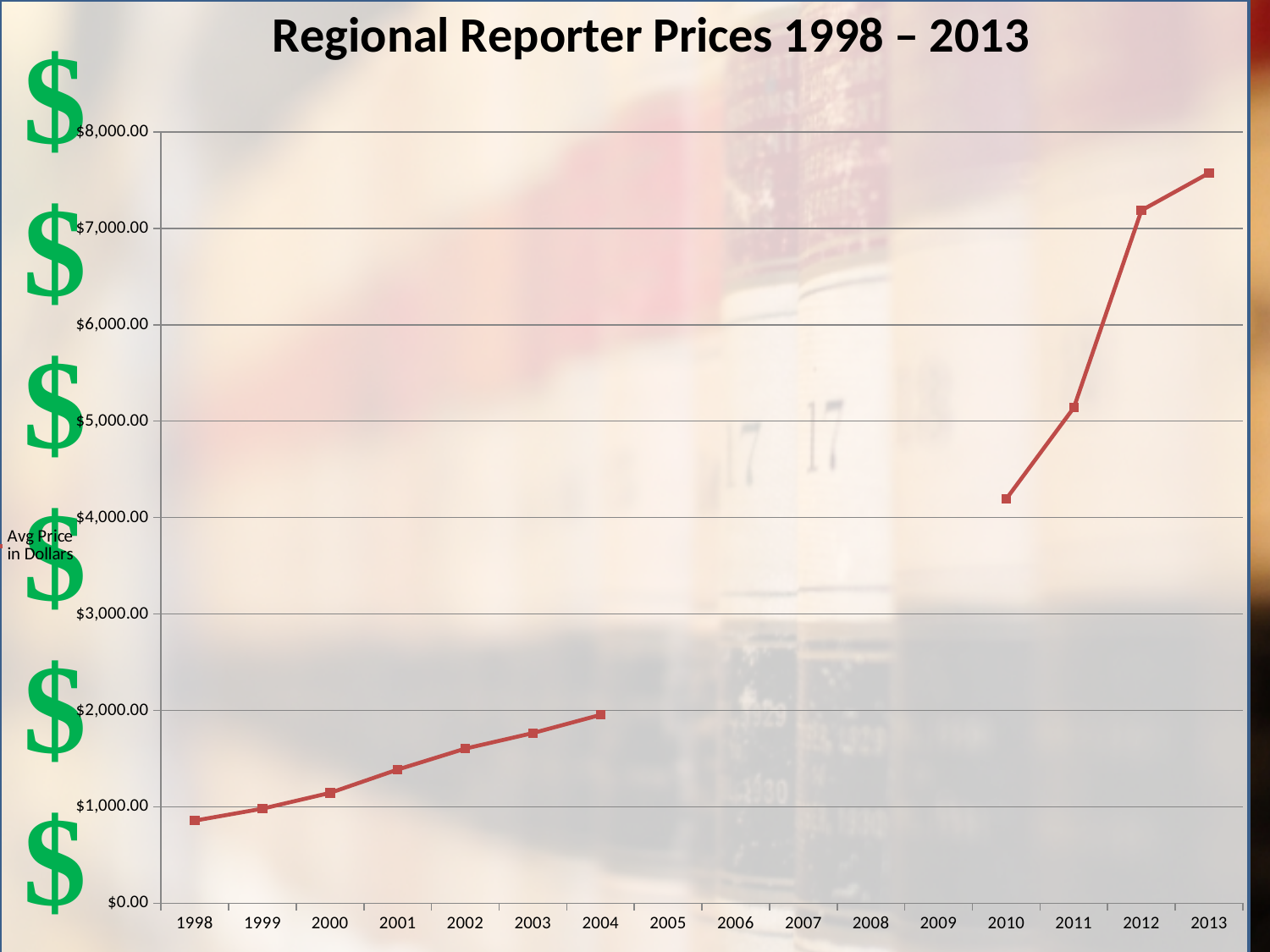
Which year has the lowest average price on the chart? 1998 What is the title of the chart? Regional Reporter Prices 1998 – 2013 What is the label on the vertical axis of the chart? Avg Price in Dollars Do the plotted values generally rise or fall from 1998 to 2013? rise Which year has the larger value, 2004 or 2011? 2011 What kind of chart is shown on the slide? line chart Is the value for 1998 greater or less than $1,000.00? less Is the value for 2002 greater or less than $1,000.00? greater Is the value for 2013 greater or less than $7,000.00? greater Which year has the highest average price on the chart? 2013